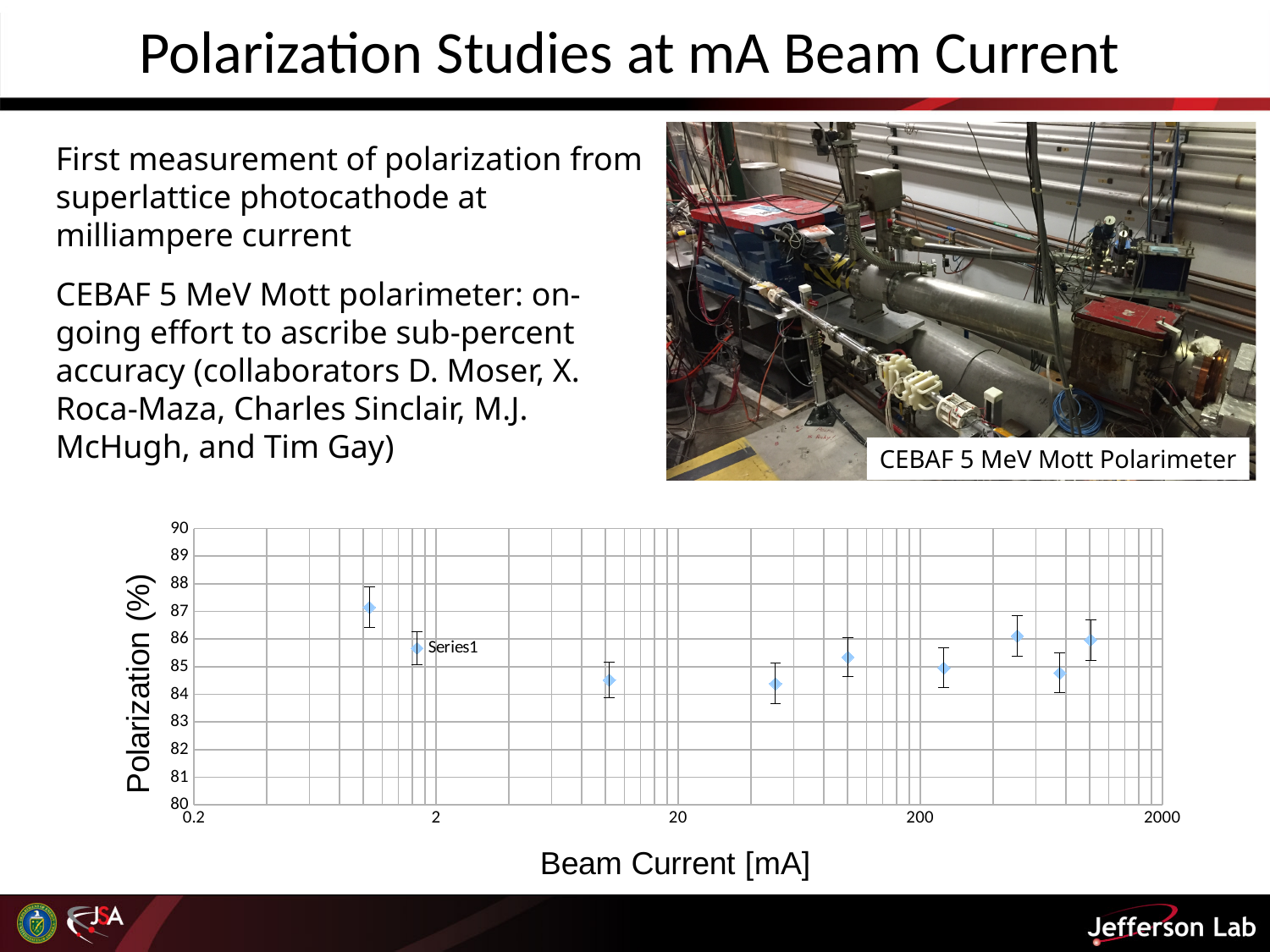
What is the label of the x axis of the chart? Beam Current [mA] Is the polarization of the leftmost data point (around 1 mA) greater or less than 86? greater Which data point has the highest polarization: the one at the lowest beam current (around 1 mA) or the one near 500 mA? The one at the lowest beam current Are all plotted polarization values greater or less than 88? less What is the label of the y axis of the chart? Polarization (%) Is the polarization of the data point near 40 mA greater or less than 85? less How many data points are plotted in the polarization chart? 9 Which data point has the highest polarization in the chart? The leftmost point, at the lowest beam current (around 1 mA) What kind of chart is shown at the bottom of the slide? Scatter chart